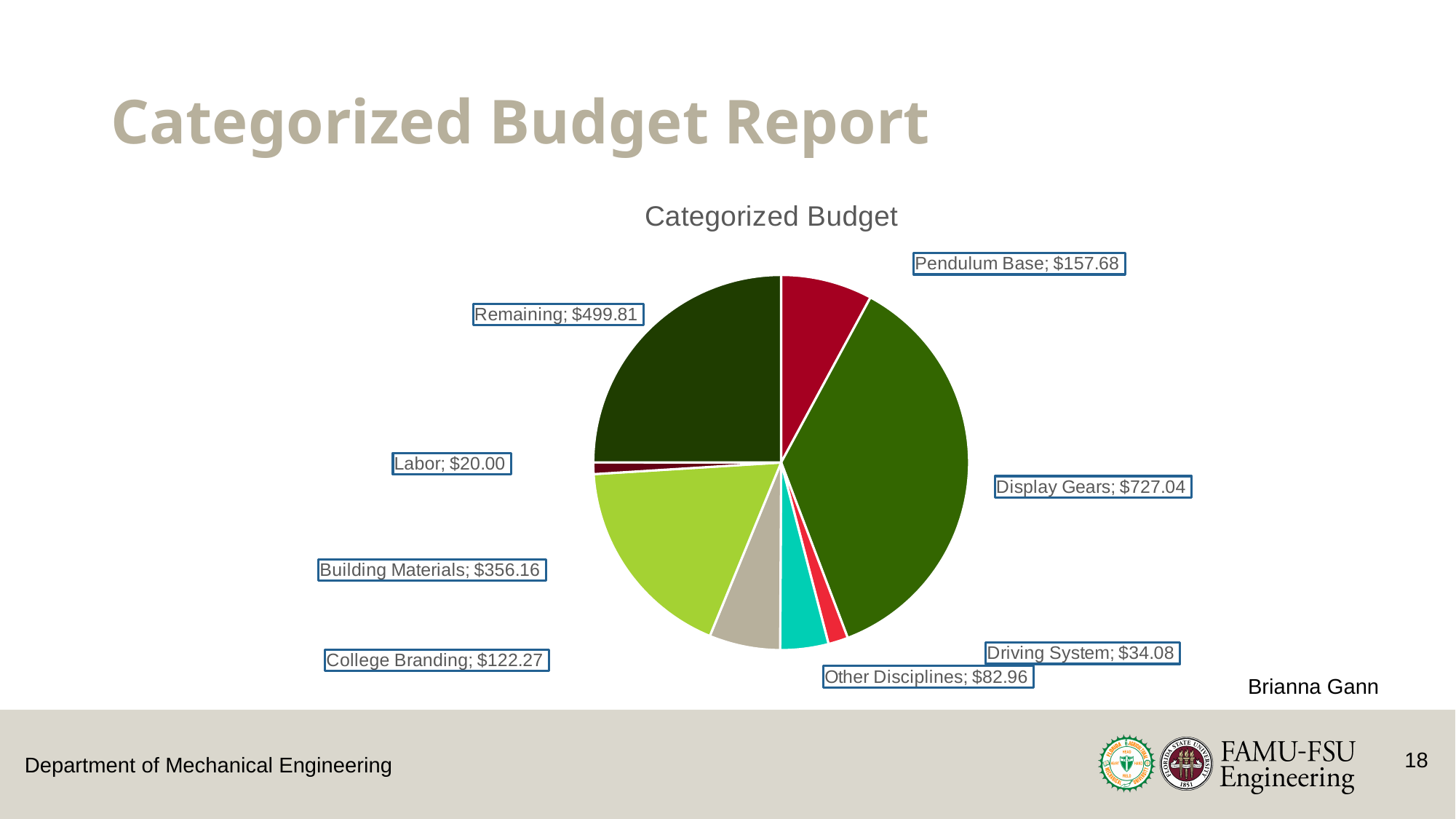
What kind of chart is shown on the slide? Pie chart What is the title of the chart? Categorized Budget Which category has the largest value? Display Gears What is the value for Building Materials? $356.16 What is the difference between Building Materials and College Branding? $233.89 What is the difference between Display Gears and Remaining? $227.23 Which is larger, Pendulum Base or Other Disciplines? Pendulum Base Which category has the smallest value? Labor What is the value for Driving System? $34.08 What is the total of all the categories in the pie chart? $2,000.00 What is the value for Display Gears? $727.04 How many categories does the pie chart show? 8